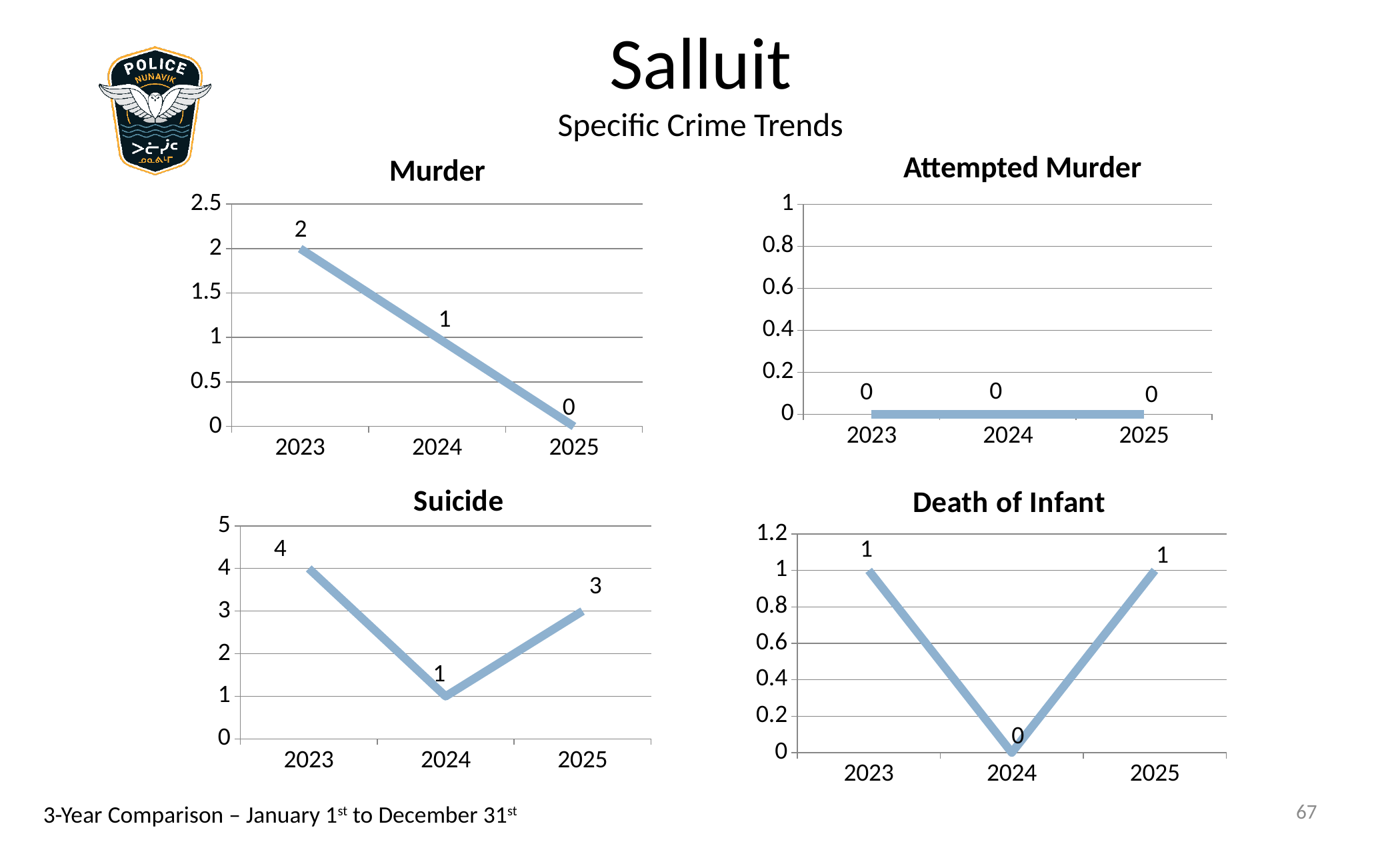
In the Suicide chart, which is larger, the value for 2024 or the value for 2025? 2025 In the Attempted Murder chart, what is the value for 2024? 0 In the Death of Infant chart, what is the value for 2024? 0 In the Suicide chart, what is the difference between the 2023 and 2025 values? 1 In the Murder chart, what is the value for 2025? 0 In the Suicide chart, which year has the highest value? 2023 In the Murder chart, do the values rise or fall from 2023 to 2025? fall In the Murder chart, what is the value for 2023? 2 What kind of chart is the Murder chart? line chart In the Death of Infant chart, how many years are plotted? 3 How many charts are shown on the slide? 4 In the Suicide chart, which year has the lowest value? 2024